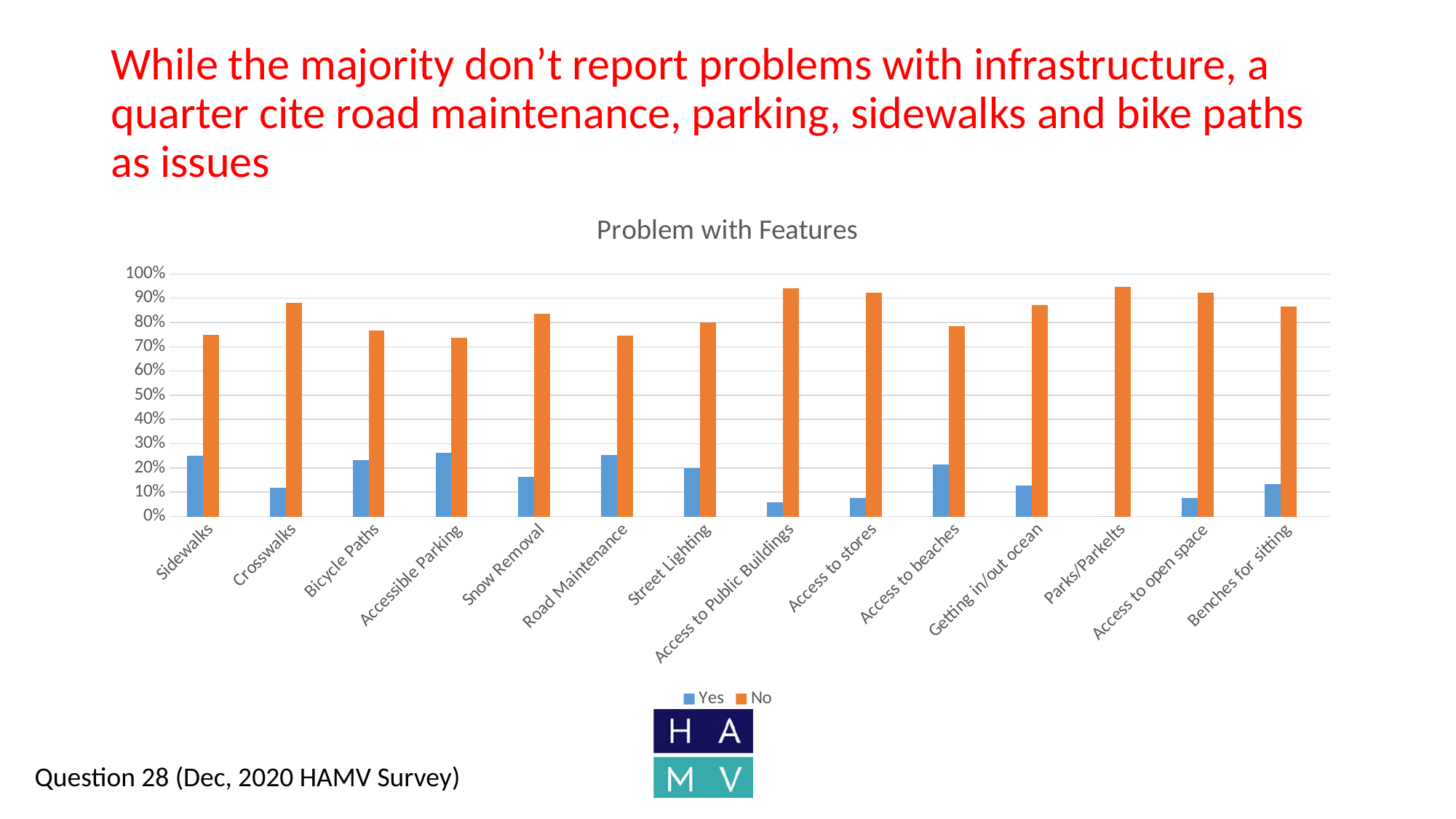
How many series does the legend list? 2 Is the 'No' value for Crosswalks greater or less than 80%? greater Is the 'Yes' value for Access to Public Buildings greater or less than 10%? less How many categories are shown on the x axis of the chart? 14 What is the title of the chart? Problem with Features What type of chart is shown on the slide? Bar chart Is the 'No' value for Accessible Parking greater or less than 80%? less Which is larger, the 'No' value for Crosswalks or the 'No' value for Sidewalks? Crosswalks Which is larger, the 'Yes' value for Sidewalks or the 'Yes' value for Crosswalks? Sidewalks Which colour represents the 'No' series in the chart? Orange